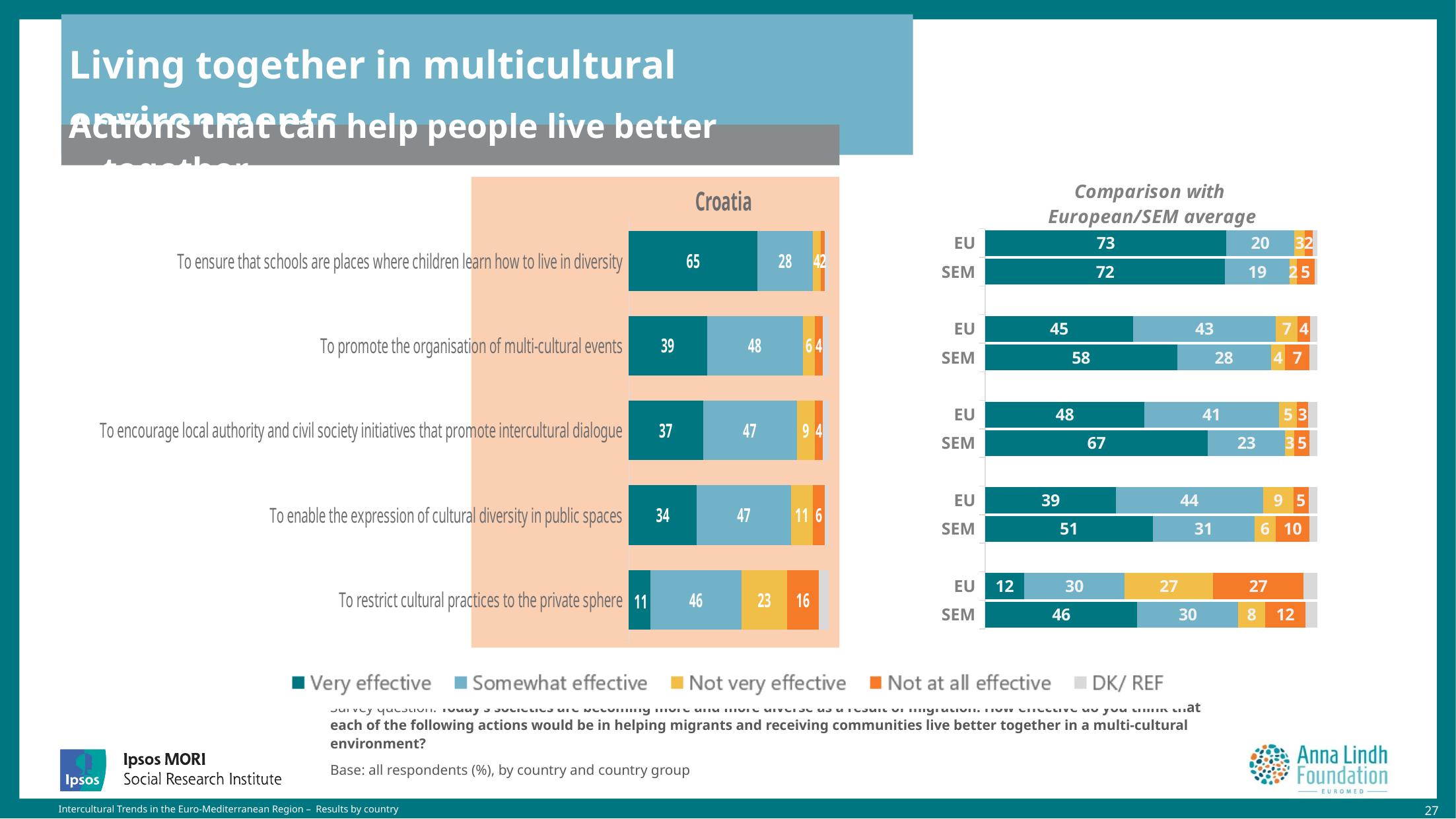
How many actions (categories) are shown in the Croatia chart? 5 In the Comparison with European/SEM average chart, what is the difference between the SEM and EU 'Very effective' values for encouraging local authority and civil society initiatives that promote intercultural dialogue? 19 In the Croatia chart, what is the difference between the 'Very effective' values for promoting multi-cultural events and enabling the expression of cultural diversity in public spaces? 5 In the Croatia chart, which action has the highest 'Very effective' value? To ensure that schools are places where children learn how to live in diversity In the Croatia chart, what percentage say ensuring that schools are places where children learn how to live in diversity is very effective? 65 What kind of chart is the Croatia chart? Stacked bar chart In the Croatia chart, which action has the lowest 'Very effective' value? To restrict cultural practices to the private sphere In the Croatia chart, what percentage say restricting cultural practices to the private sphere is not at all effective? 16 In the Comparison with European/SEM average chart, what is the EU 'Very effective' value for ensuring schools are places where children learn how to live in diversity? 73 In the Comparison with European/SEM average chart, what is the SEM 'Very effective' value for restricting cultural practices to the private sphere? 46 In the Croatia chart, is the 'Somewhat effective' value larger for promoting multi-cultural events or for ensuring schools teach living in diversity? To promote the organisation of multi-cultural events How many series does the legend list? 5